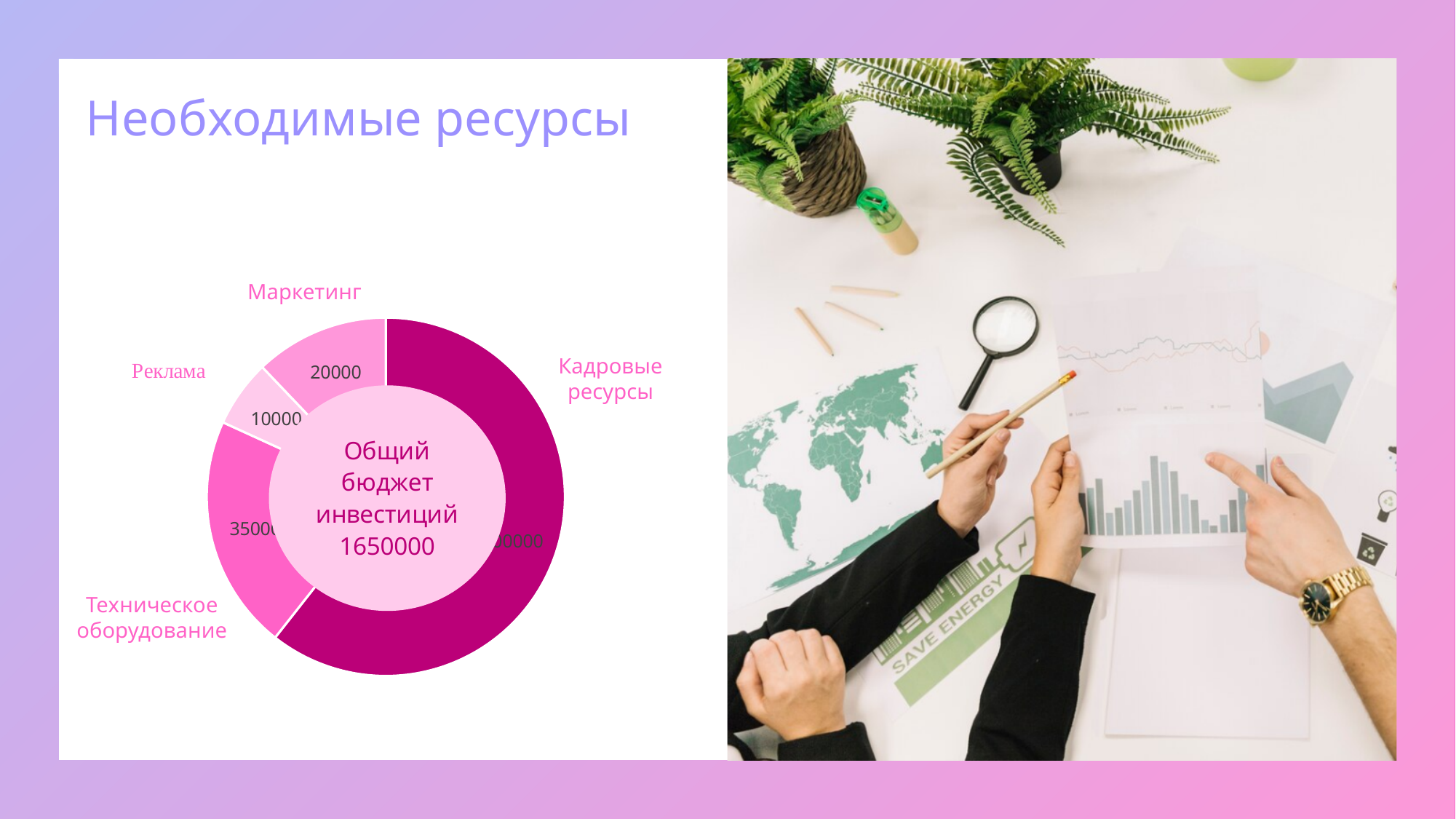
What is the value for Маркетинг? 20000 What total investment budget is written in the centre of the doughnut chart? 1650000 What is the title of the slide containing the chart? Необходимые ресурсы Which category has the smallest slice of the doughnut chart? Реклама What is the value for Реклама? 10000 Which is larger, the value for Маркетинг or the value for Реклама? Маркетинг Which category has the largest slice of the doughnut chart? Кадровые ресурсы What kind of chart is shown on the slide? Doughnut (pie) chart What is the difference between the values for Маркетинг and Реклама? 10000 How many categories does the doughnut chart show? 4 Which is larger, the slice for Кадровые ресурсы or the slice for Техническое оборудование? Кадровые ресурсы